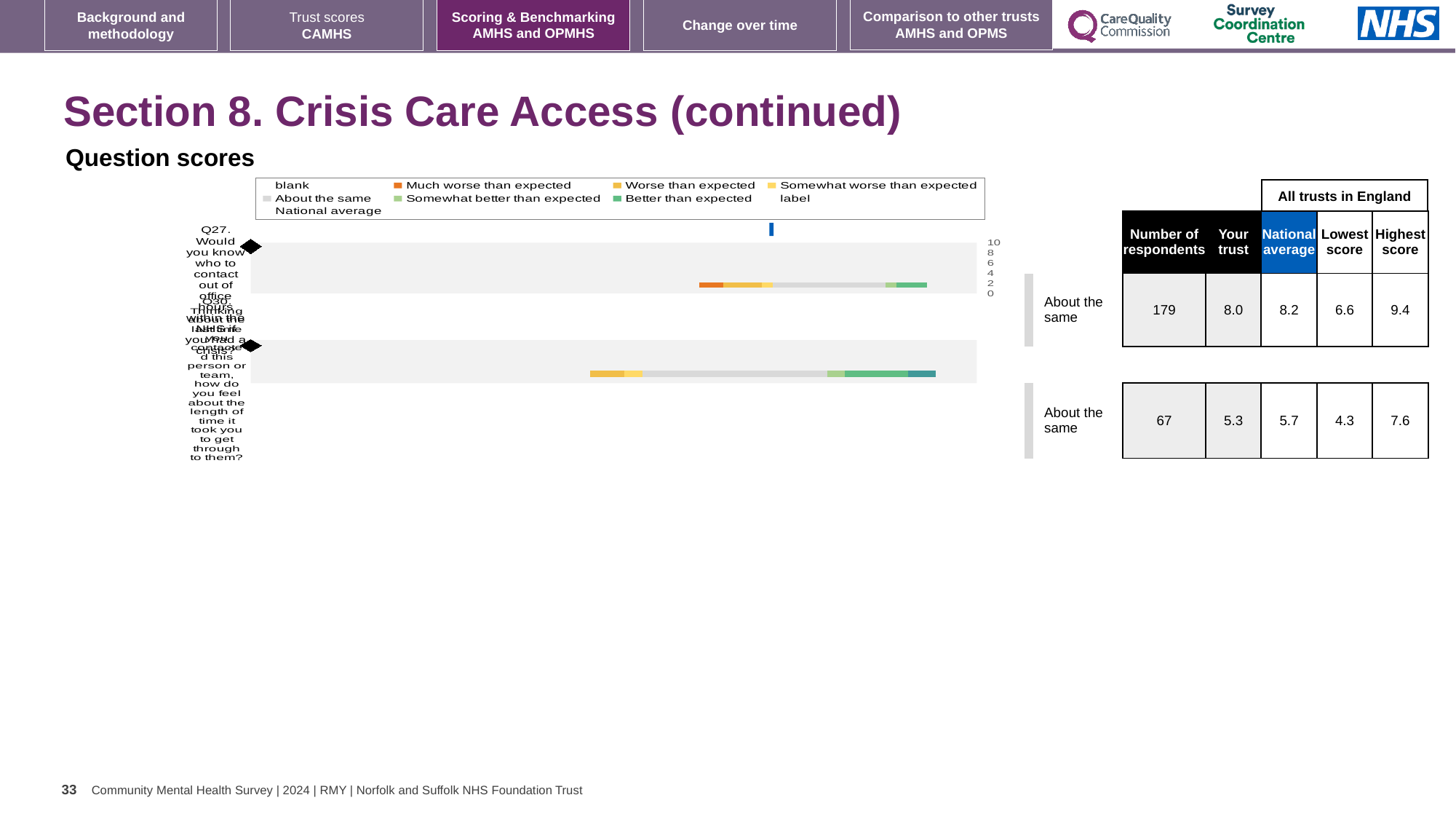
What colour represents 'Much worse than expected' in the chart legend? orange How many questions (bars) are plotted in the chart? 2 How many entries does the chart legend list? 9 In the table beside the chart, what is the difference between the highest and lowest score for Q27? 2.8 What is the highest tick value shown on the chart's score axis? 10 In the table beside the chart, how many respondents answered Q27? 179 In the table beside the chart, what is the benchmark category shown for Q30? About the same What kind of chart is shown under 'Question scores'? bar chart In the table beside the chart, what is the highest score for Q30? 7.6 In the table beside the chart, what is the national average for Q30? 5.7 In the table beside the chart, what is the 'Your trust' score for Q27? 8.0 In the table beside the chart, which question has the higher 'Your trust' score, Q27 or Q30? Q27